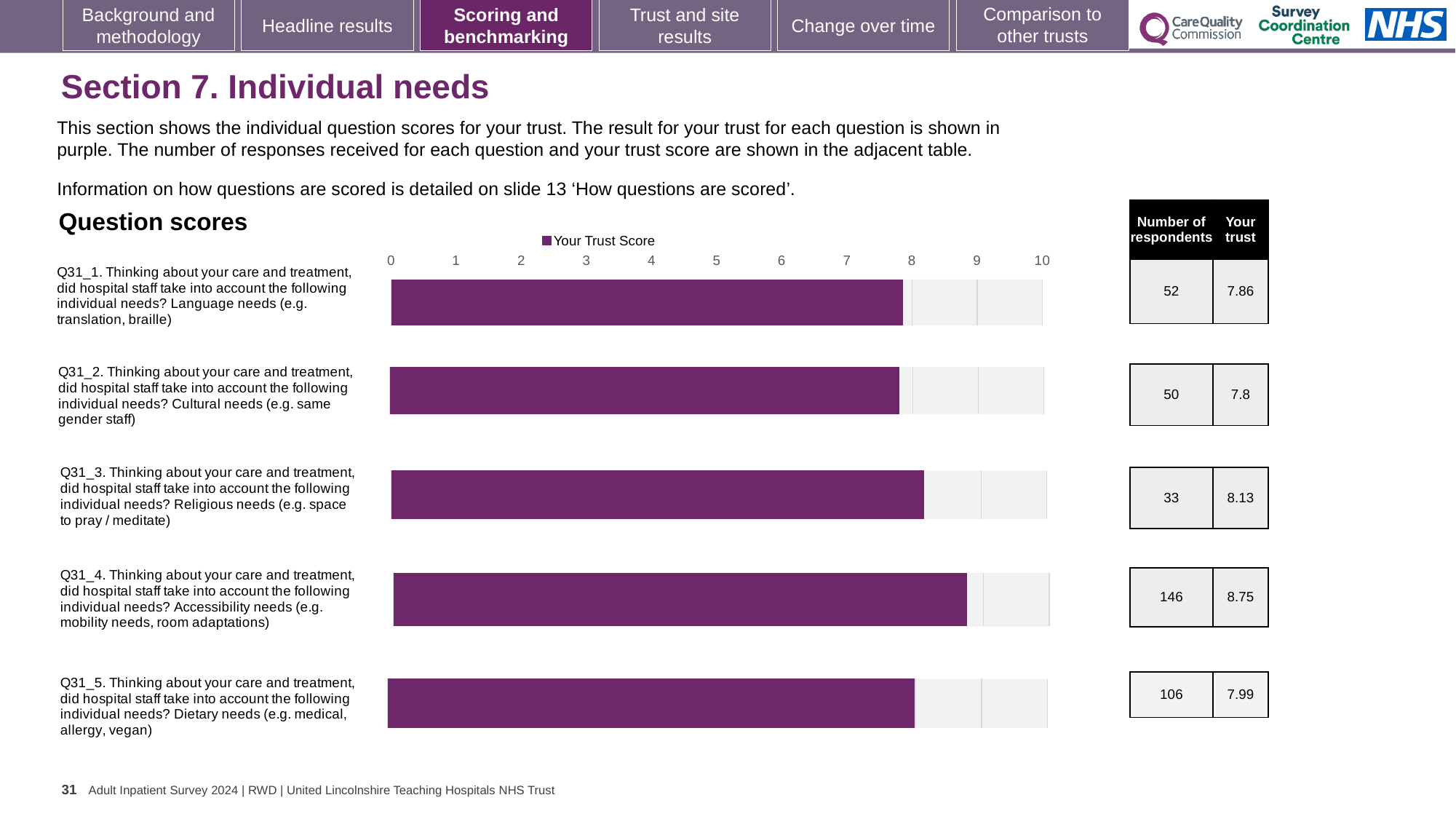
What is the trust score for Q31_1 (Language needs)? 7.86 What is the difference between the trust scores for Q31_4 and Q31_2? 0.95 What is the trust score for Q31_4 (Accessibility needs)? 8.75 How many questions are plotted in the chart? 5 Which question has the lowest trust score? Q31_2 (Cultural needs) Is the trust score for Q31_4 greater or less than 8? greater What is the trust score for Q31_3 (Religious needs)? 8.13 Which has the larger trust score, Q31_3 or Q31_5? Q31_3 What is the name of the series shown in the chart legend? Your Trust Score Is the trust score for Q31_2 greater or less than 8? less Which question has the highest trust score? Q31_4 (Accessibility needs) What type of chart is used to show the question scores? Bar chart